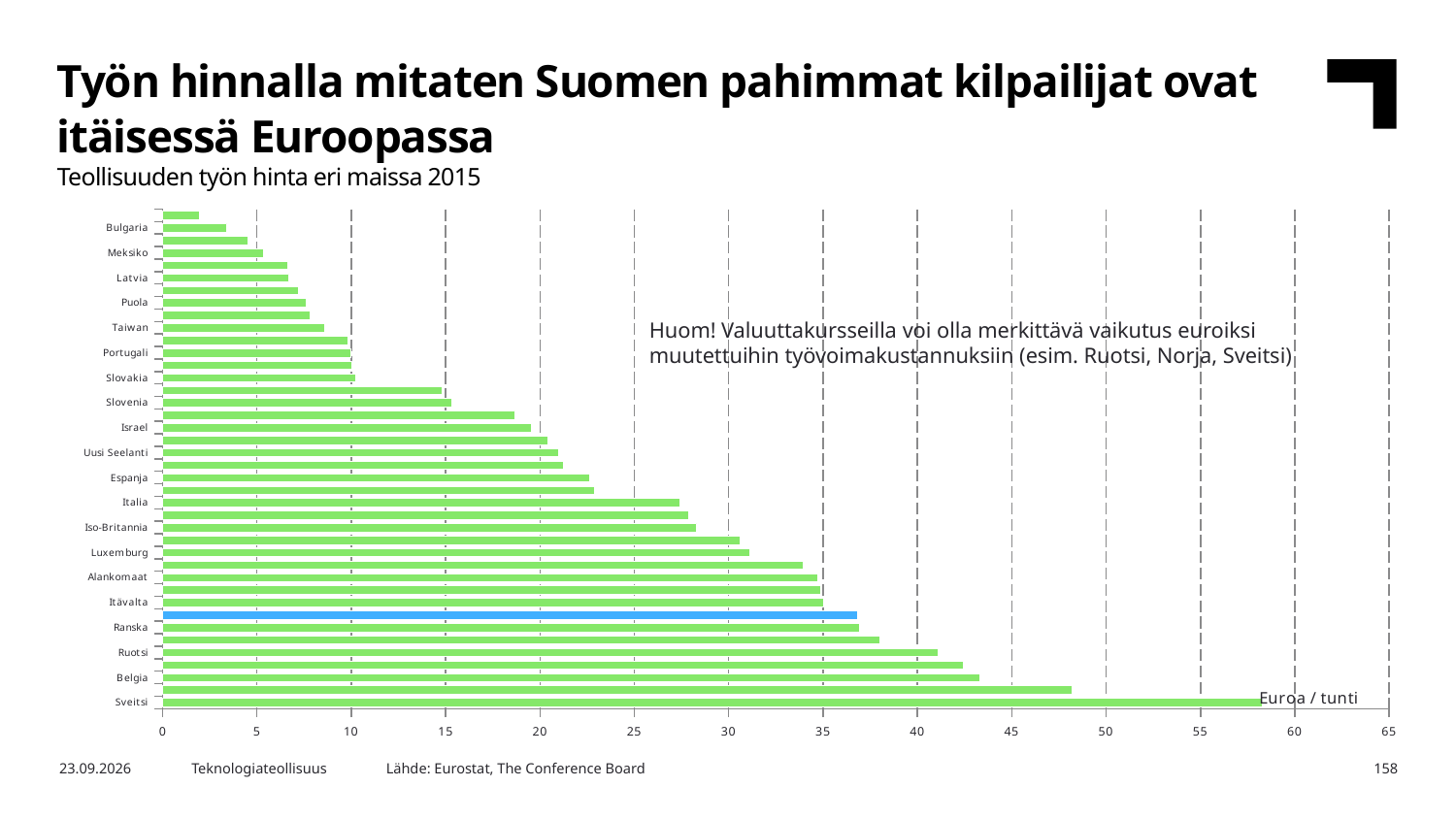
Which country has the highest labour cost in the chart? Sveitsi Is the value for Taiwan greater or less than 10? less What kind of chart is shown on the slide? bar chart Which has the higher value, Belgia or Ruotsi? Belgia Is the value for Sveitsi greater or less than 55? greater What is the subtitle of the chart? Teollisuuden työn hinta eri maissa 2015 What unit is shown on the chart's value axis? Euroa / tunti Is the value for Bulgaria greater or less than 5? less Which has the higher value, Italia or Espanja? Italia